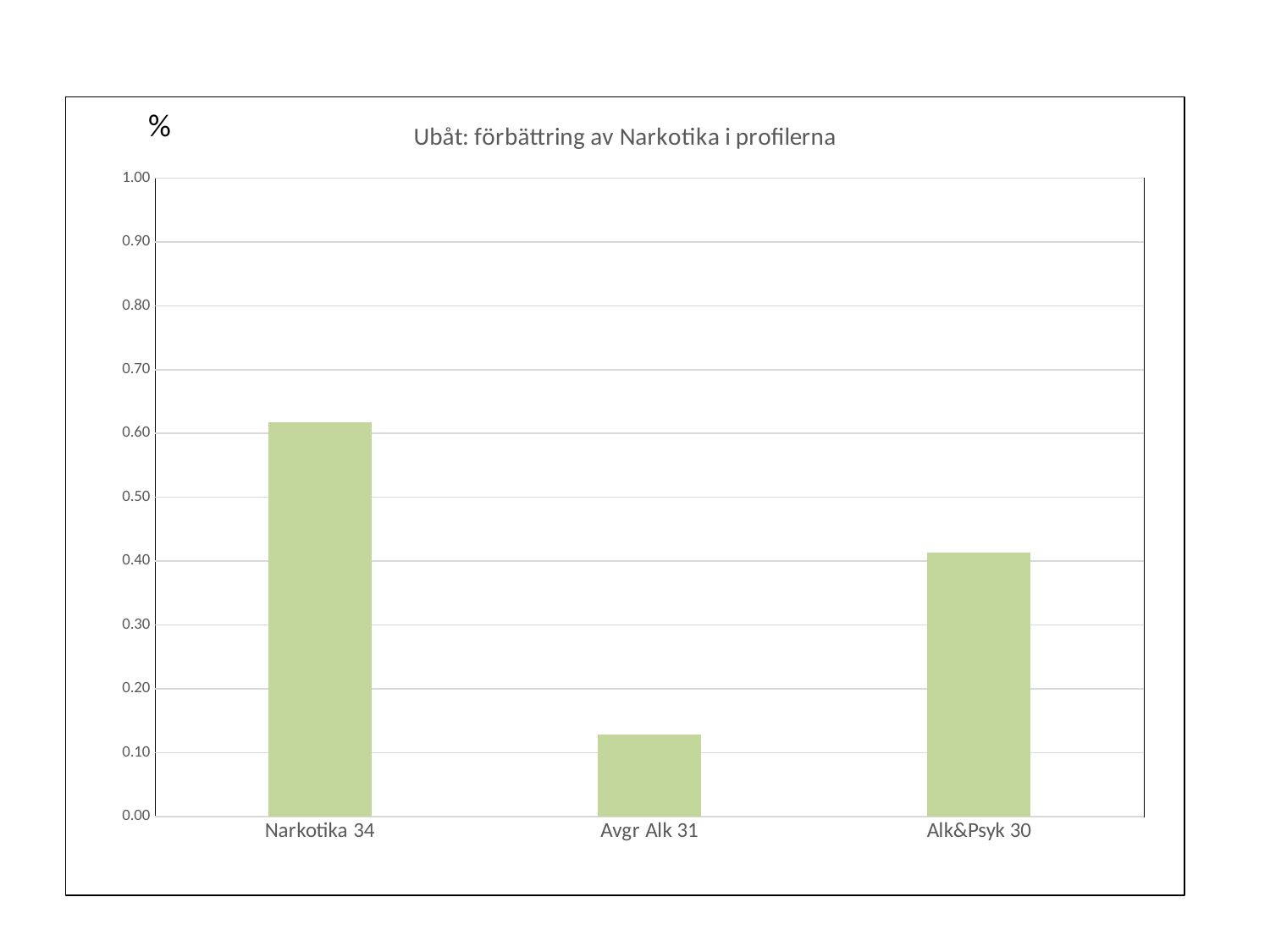
How many categories are plotted in the chart? 3 Is the value for Avgr Alk 31 greater or less than 0.20? less Is the value for Alk&Psyk 30 greater or less than 0.30? greater Is the value for Narkotika 34 greater or less than 0.70? less Which category has the lowest value? Avgr Alk 31 What kind of chart is shown on the slide? bar chart Which is larger, the value for Narkotika 34 or the value for Alk&Psyk 30? Narkotika 34 What is the highest value shown on the vertical axis? 1.00 What is the title of the chart? Ubåt: förbättring av Narkotika i profilerna Which category has the highest value? Narkotika 34 Which is larger, the value for Alk&Psyk 30 or the value for Avgr Alk 31? Alk&Psyk 30